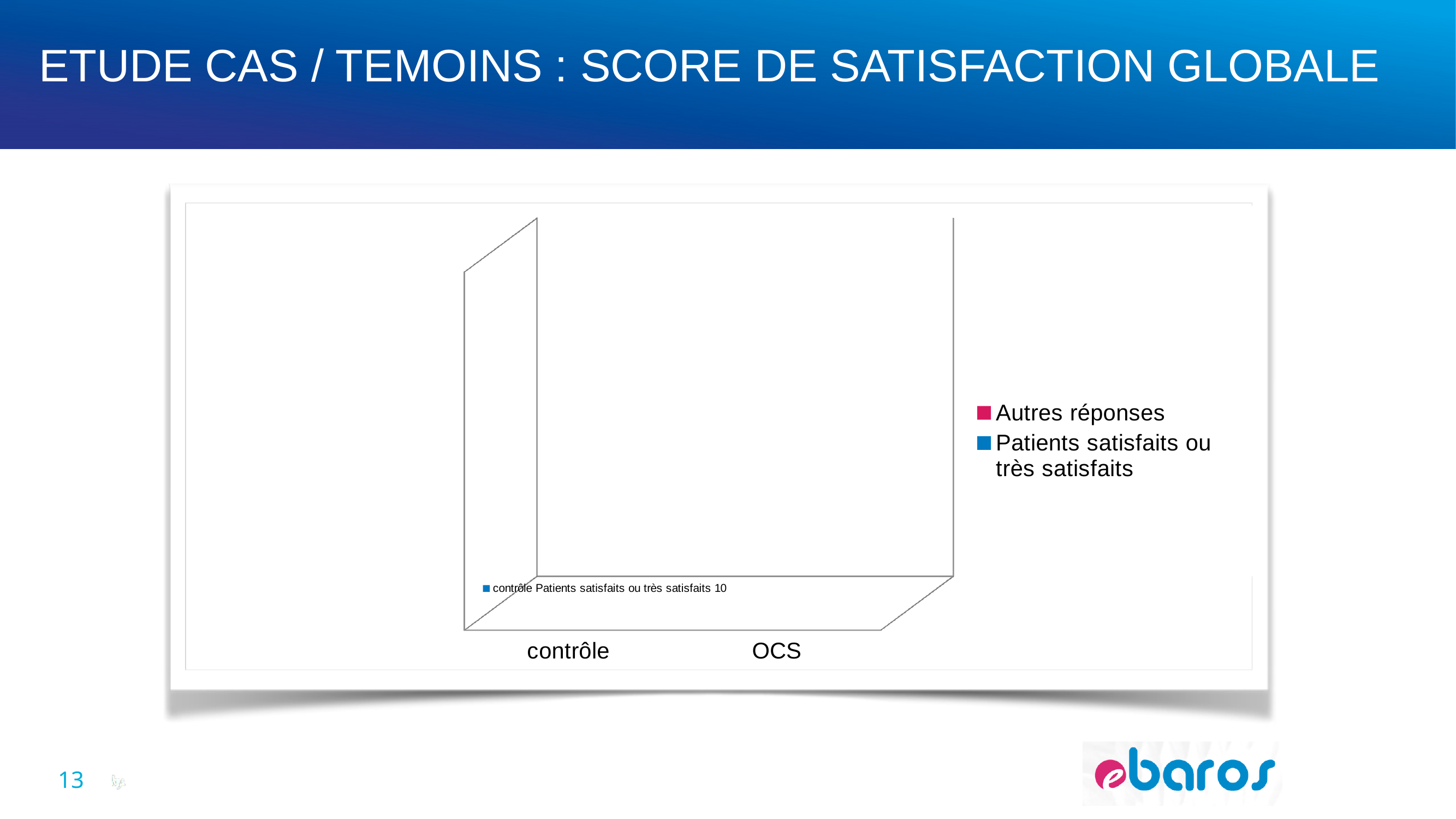
How many categories are shown on the x axis? 2 What is the value for 'Patients satisfaits ou très satisfaits' in the 'contrôle' category? 10 What are the two categories on the x axis? contrôle and OCS How many series does the legend list? 2 Which legend entry is shown in blue? Patients satisfaits ou très satisfaits